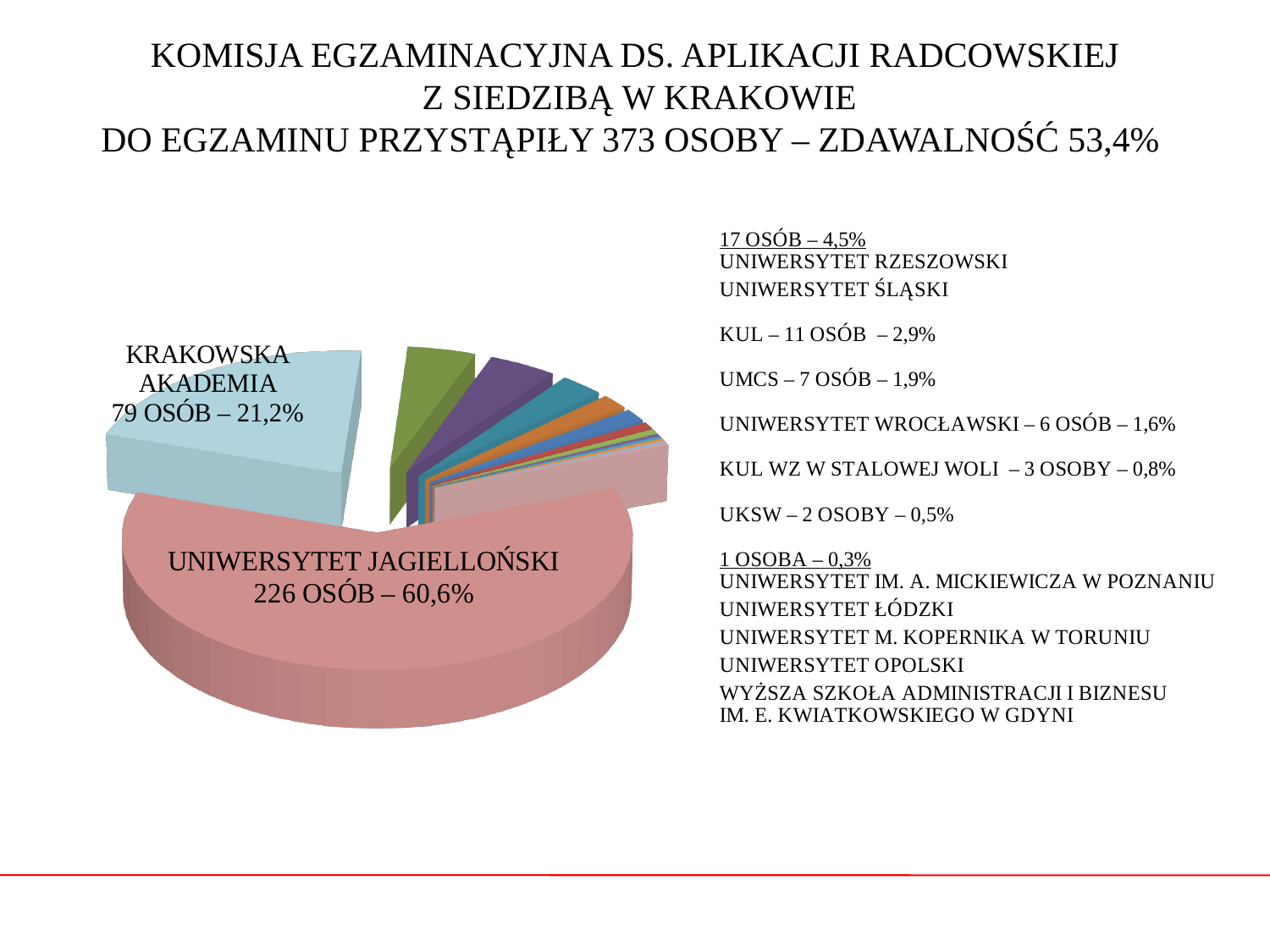
What percentage of the pie does UMCS represent? 1,9% What is the difference in number of people between Uniwersytet Jagielloński and Krakowska Akademia? 147 What is the total number of people who took the exam, as stated in the chart title? 373 How many people from Uniwersytet Jagielloński took the exam according to the chart? 226 osób Which university has the largest slice of the pie? Uniwersytet Jagielloński How many people does the slice for Uniwersytet Rzeszowski represent? 17 osób What share of the pie does Krakowska Akademia represent? 21,2% How many people from KUL took the exam, and what percentage is that? 11 osób – 2,9% Which is larger: the value for Uniwersytet Wrocławski or the value for UKSW? Uniwersytet Wrocławski What share of the pie does Uniwersytet Jagielloński represent? 60,6% How many people from Krakowska Akademia took the exam? 79 osób What kind of chart is shown on the slide? pie chart